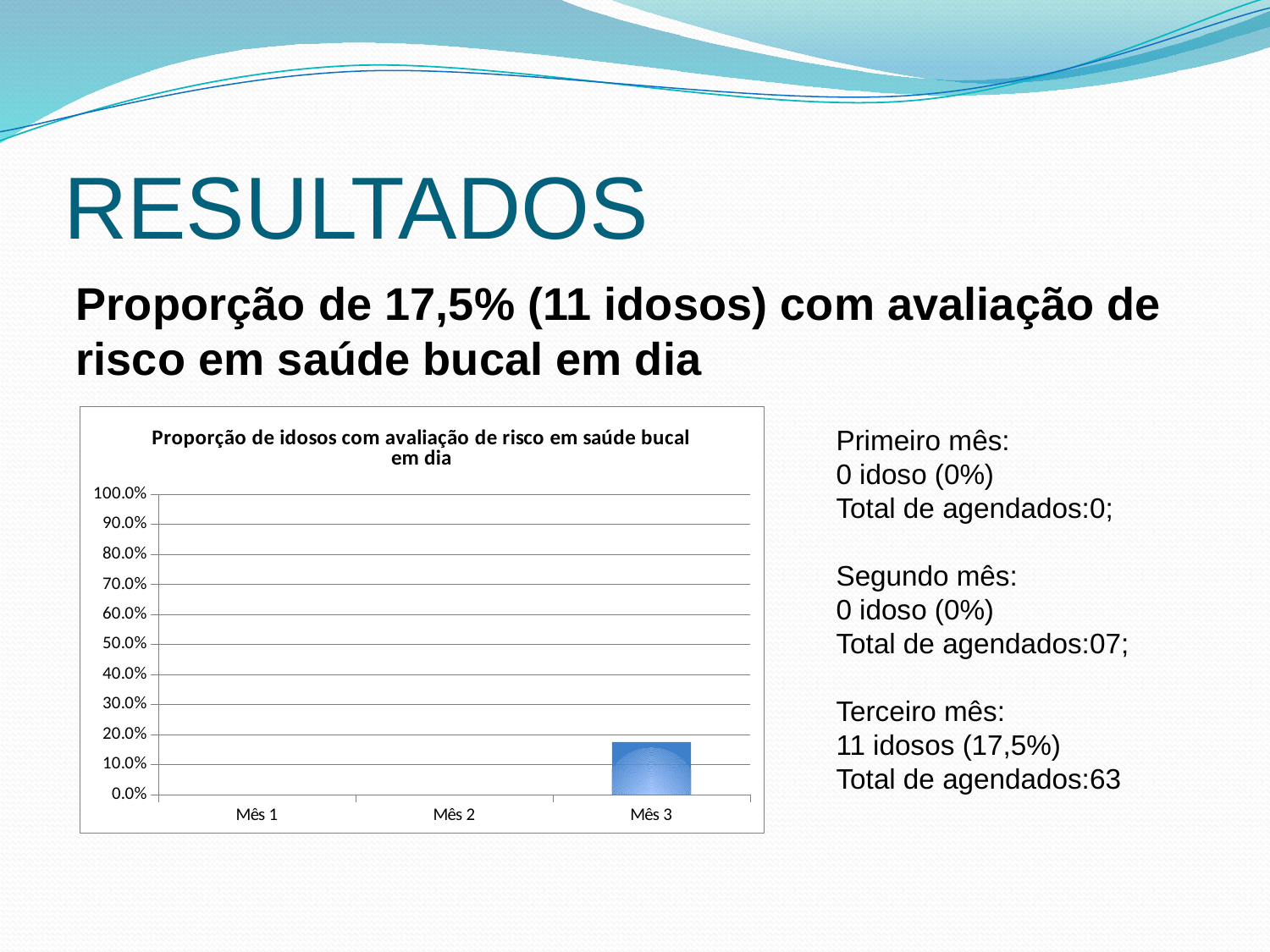
Which month has the highest value in the chart? Mês 3 Do the values in the chart rise or fall from Mês 1 to Mês 3? rise What is the title of the chart? Proporção de idosos com avaliação de risco em saúde bucal em dia Is the value for Mês 3 greater or less than 10.0%? greater What kind of chart is shown on the slide? bar chart What is the highest tick value shown on the y axis of the chart? 100.0% Which is larger, the value for Mês 2 or the value for Mês 3? Mês 3 What is the value for Mês 2 in the chart? 0.0% How many categories are shown on the x axis of the chart? 3 Is the value for Mês 3 greater or less than 20.0%? less What is the value for Mês 1 in the chart? 0.0%